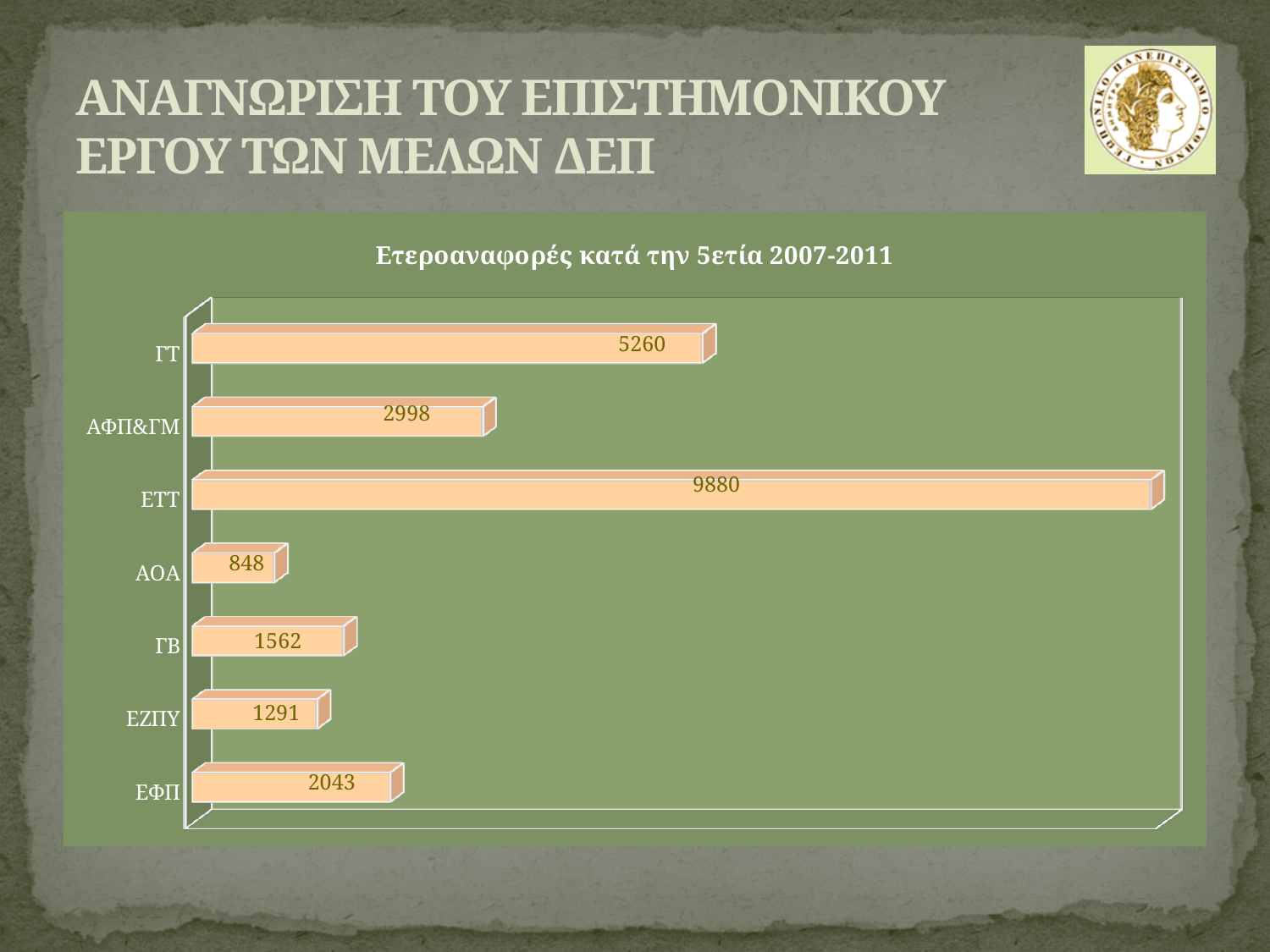
What is the value for ΑΟΑ? 848 What is the title of the chart? Ετεροαναφορές κατά την 5ετία 2007-2011 What kind of chart is shown on the slide? bar chart Which is larger, the value for ΑΦΠ&ΓΜ or the value for ΕΦΠ? ΑΦΠ&ΓΜ What is the value for ΕΦΠ? 2043 What is the difference between the values for ΕΤΤ and ΓΤ? 4620 Which category has the lowest value? ΑΟΑ Which category has the highest value? ΕΤΤ What is the value for ΕΤΤ? 9880 How many categories are shown in the chart? 7 What is the value for ΓΤ? 5260 What is the difference between the values for ΓΒ and ΕΖΠΥ? 271